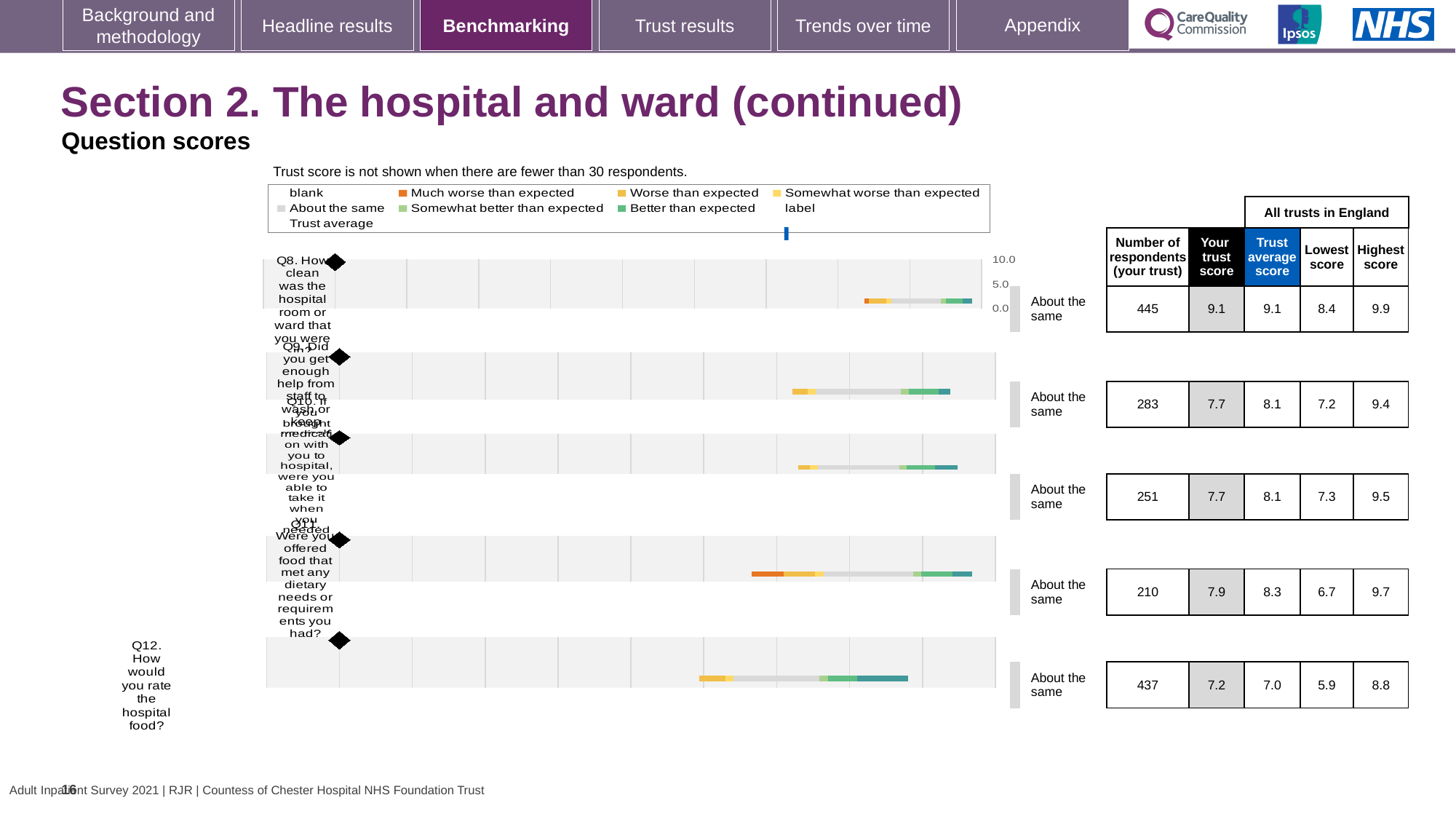
Which question has the lowest 'Your trust score'? Q12 What is the highest score across all trusts in England for Q11 (Were you offered food that met any dietary needs or requirements you had?)? 9.7 Which is larger: the 'Your trust score' for Q11 or for Q12? Q11 Is the 'Your trust score' for Q12 greater or less than the trust average score for Q12? greater What is the difference between the 'Your trust score' for Q8 and for Q12? 1.9 What benchmark category is shown for Q10 (If you brought medication with you to hospital, were you able to take it when you needed to?)? About the same How many respondents from your trust answered Q12 (How would you rate the hospital food?)? 437 How many questions are plotted on the chart? 5 What is the 'Your trust score' for Q8 (How clean was the hospital room or ward that you were in?)? 9.1 What is the trust average score for Q9 (Did you get enough help from staff to wash or keep yourself clean?)? 8.1 What kind of chart is shown on the slide? Bar chart Which question has the highest 'Your trust score'? Q8